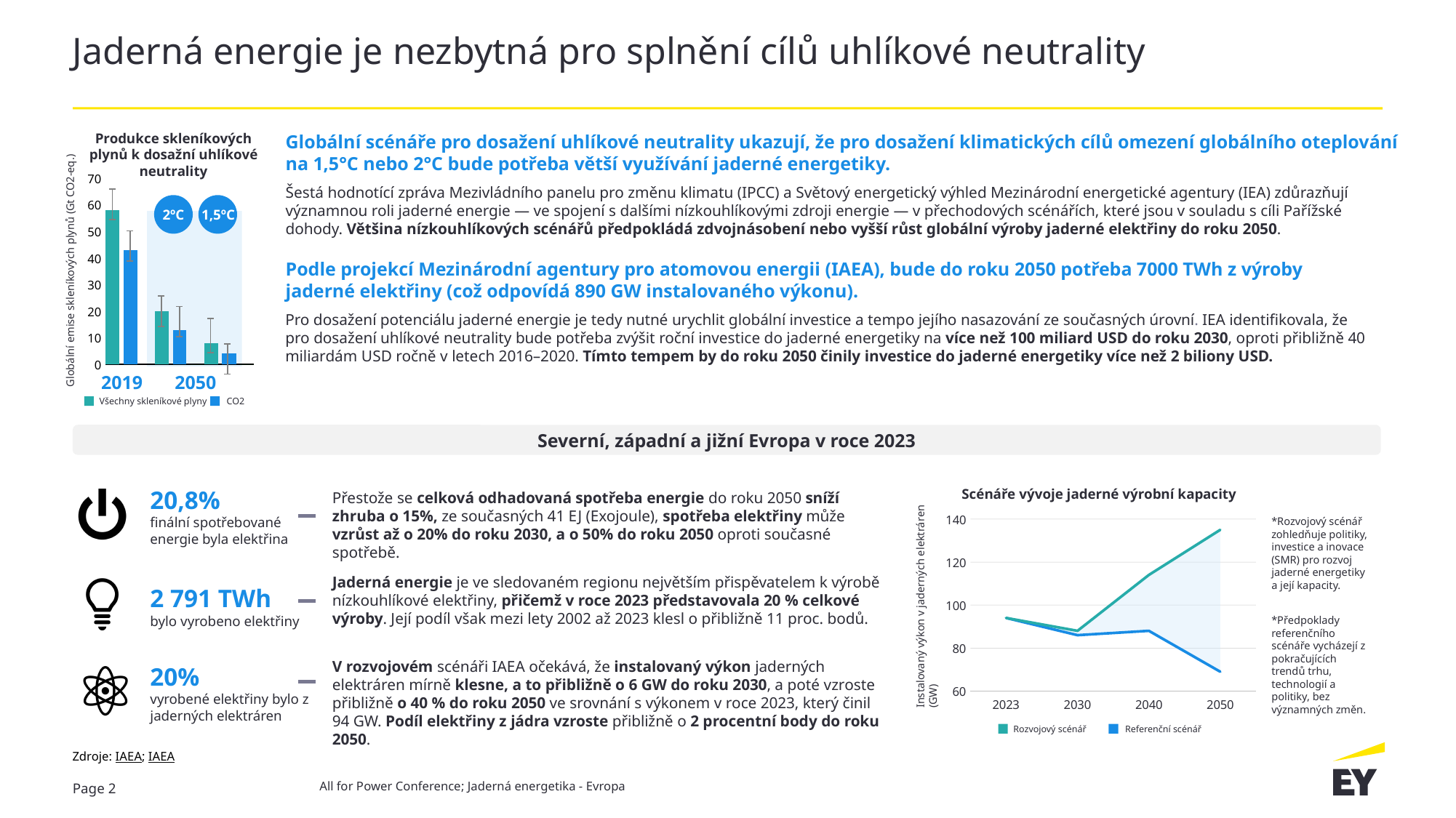
What kind of chart is the chart titled "Produkce skleníkových plynů k dosažní uhlíkové neutrality"? bar chart How many series does the legend of the chart "Scénáře vývoje jaderné výrobní kapacity" list? 2 How many series does the legend of the chart "Produkce skleníkových plynů k dosažní uhlíkové neutrality" list? 2 What kind of chart is the chart titled "Scénáře vývoje jaderné výrobní kapacity"? line chart In the chart "Scénáře vývoje jaderné výrobní kapacity", does the "Referenční scénář" line rise or fall between 2040 and 2050? fall In the chart "Scénáře vývoje jaderné výrobní kapacity", is the value of "Rozvojový scénář" in 2050 greater or less than 120? greater In the chart "Produkce skleníkových plynů k dosažní uhlíkové neutrality", is the CO2 value for 2019 greater or less than 50? less In the chart "Produkce skleníkových plynů k dosažní uhlíkové neutrality", is the value of "Všechny skleníkové plyny" for 2019 greater or less than 50? greater How many years are shown on the x axis of the chart "Scénáře vývoje jaderné výrobní kapacity"? 4 In the chart "Produkce skleníkových plynů k dosažní uhlíkové neutrality", which is larger for 2019: "Všechny skleníkové plyny" or CO2? Všechny skleníkové plyny In the chart "Produkce skleníkových plynů k dosažní uhlíkové neutrality", what is the unit shown on the vertical axis? Gt CO2-eq.